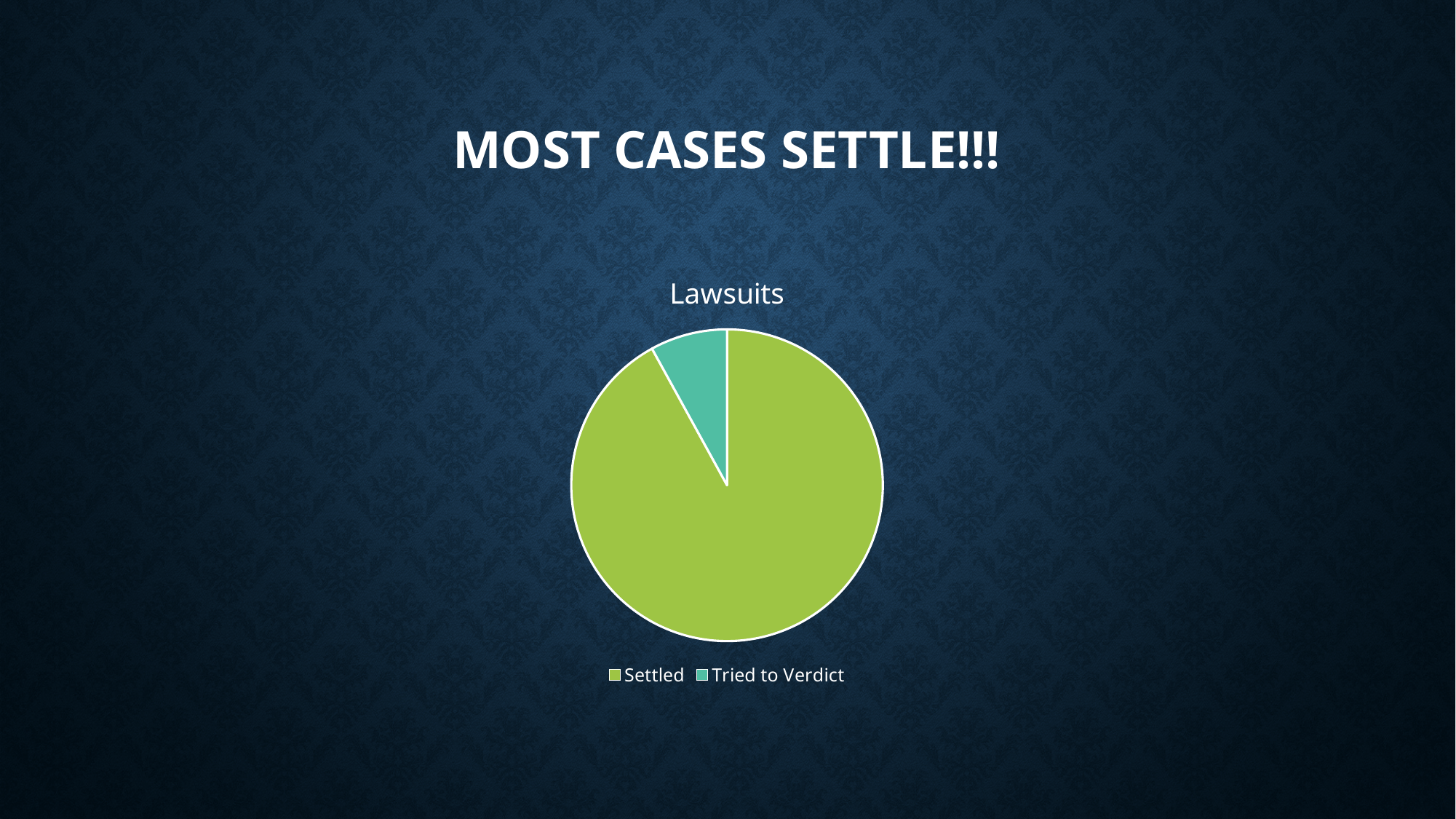
What colour is the Settled slice? green How many slices does the pie chart have? 2 What kind of chart is shown on the slide? pie chart Which category has the smallest slice of the pie? Tried to Verdict Which category has the largest slice of the pie? Settled Which slice is larger, Settled or Tried to Verdict? Settled What is the title of the chart? Lawsuits How many entries does the legend list? 2